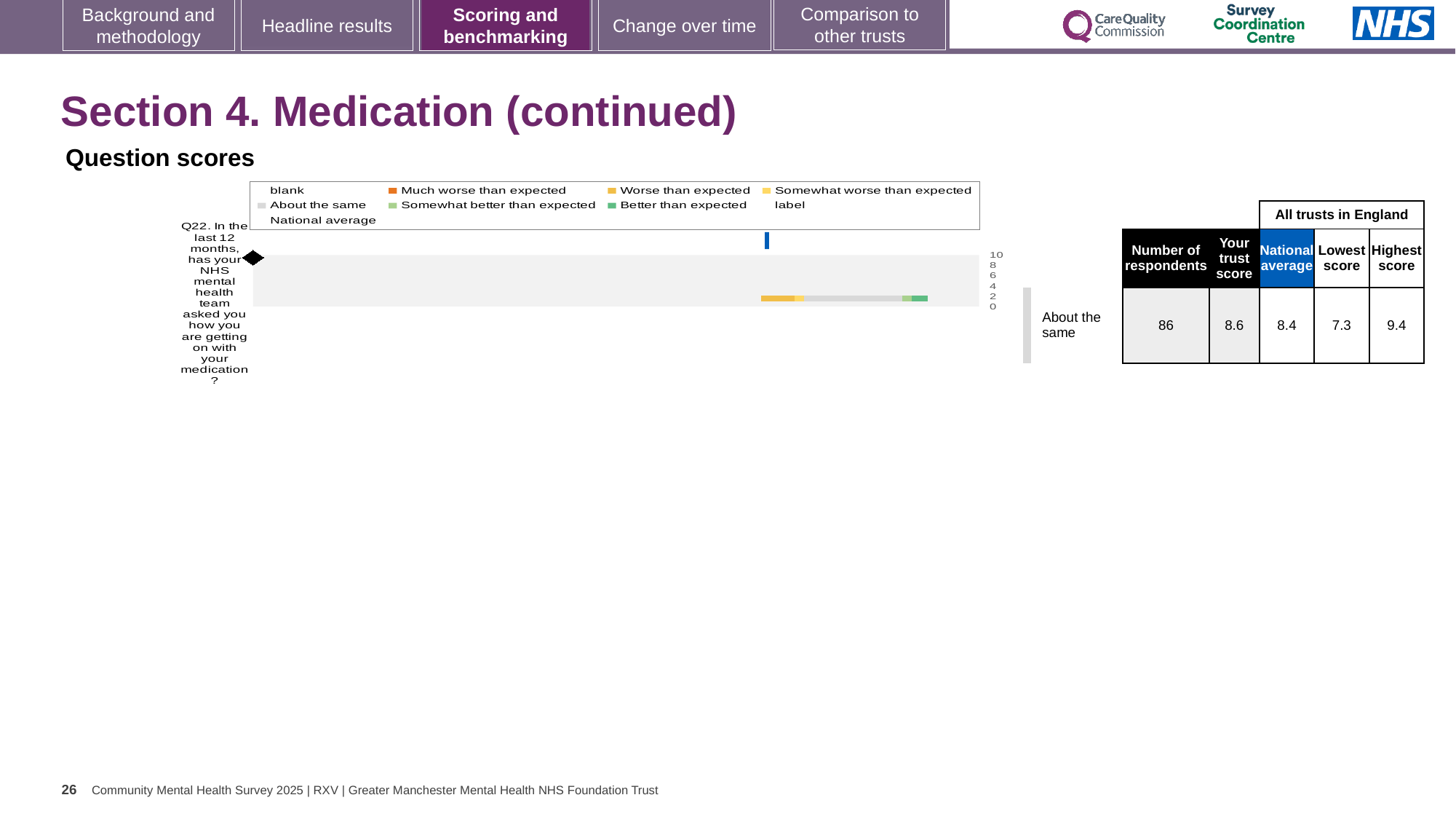
Which is larger for Q22: the trust's score or the national average? Your trust score What is the lowest score among all trusts in England for Q22? 7.3 How many respondents answered Q22? 86 How many questions are plotted in the chart? 1 What is the national average score for Q22? 8.4 Is the trust's score for Q22 greater or less than 8? greater What is the highest score among all trusts in England for Q22? 9.4 Which benchmark category is the trust's Q22 result placed in? About the same What kind of chart is used to show the question scores? bar chart By how much does the trust's score for Q22 exceed the national average? 0.2 What is the difference between the highest and lowest scores for Q22 across all trusts in England? 2.1 What is the trust's score for Q22 shown in the table? 8.6